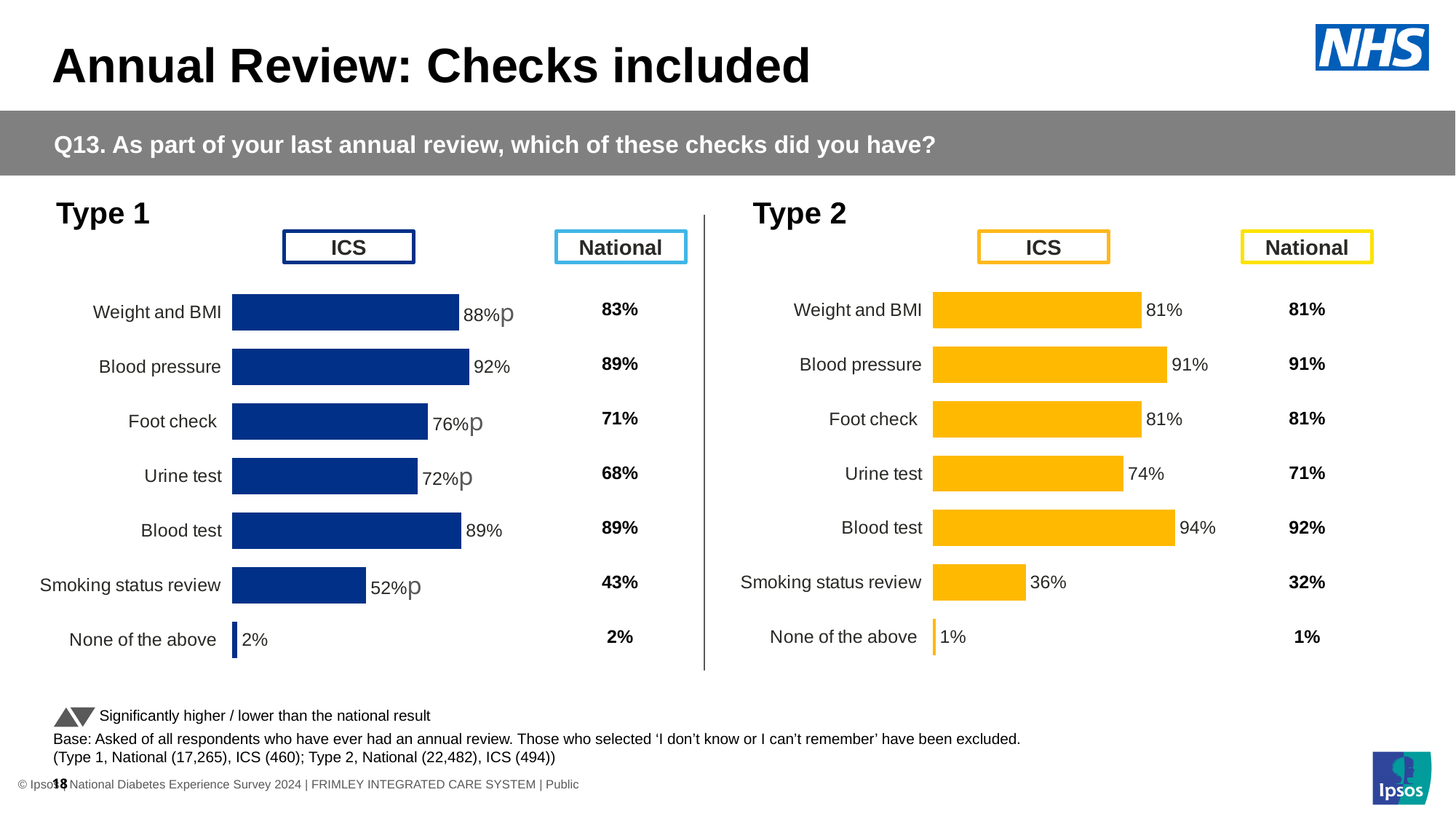
In the Type 2 chart, what is the difference between the ICS values for Blood test and Urine test? 20 percentage points In the Type 2 chart, which check has the highest ICS value? Blood test What colour are the ICS bars in the Type 1 chart? Dark blue In the Type 1 chart, what is the National value for Foot check? 71% In the Type 2 chart, what is the ICS value for Smoking status review? 36% In the Type 1 chart, what is the ICS value for Blood pressure? 92% In the Type 1 chart, which category has the lowest ICS value? None of the above What type of chart is used to show the ICS values in the Type 2 chart? Bar chart How many checks (categories) are listed in the Type 1 chart? 7 In the Type 1 chart, which is larger: the ICS value for Foot check or the ICS value for Urine test? Foot check In the Type 1 chart, what is the difference between the ICS and National values for Smoking status review? 9 percentage points In the Type 2 chart, is the ICS value for Weight and BMI larger or smaller than the National value for Weight and BMI? They are equal (81%)